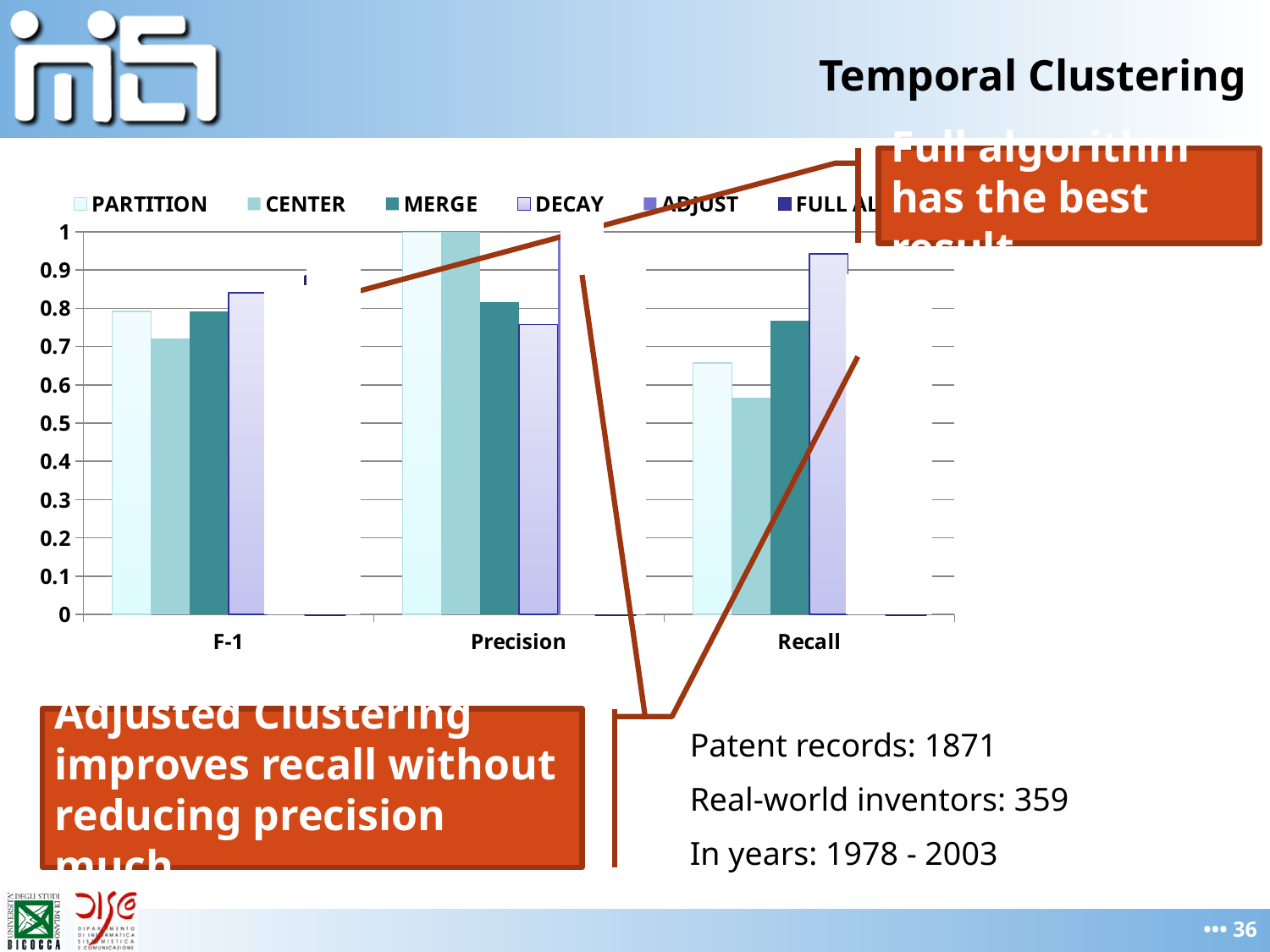
Is the DECAY value for Precision greater or less than 0.8? less For F-1, which is larger: the DECAY value or the CENTER value? DECAY What is the first series listed in the chart legend? PARTITION Is the MERGE value for Recall greater or less than 0.7? greater Is the MERGE value for Precision greater or less than 0.9? less What are the category labels on the x axis of the chart? F-1, Precision, Recall What kind of chart is shown on the slide? bar chart For Recall, which is larger: the DECAY value or the CENTER value? DECAY How many categories are shown on the x axis of the chart? 3